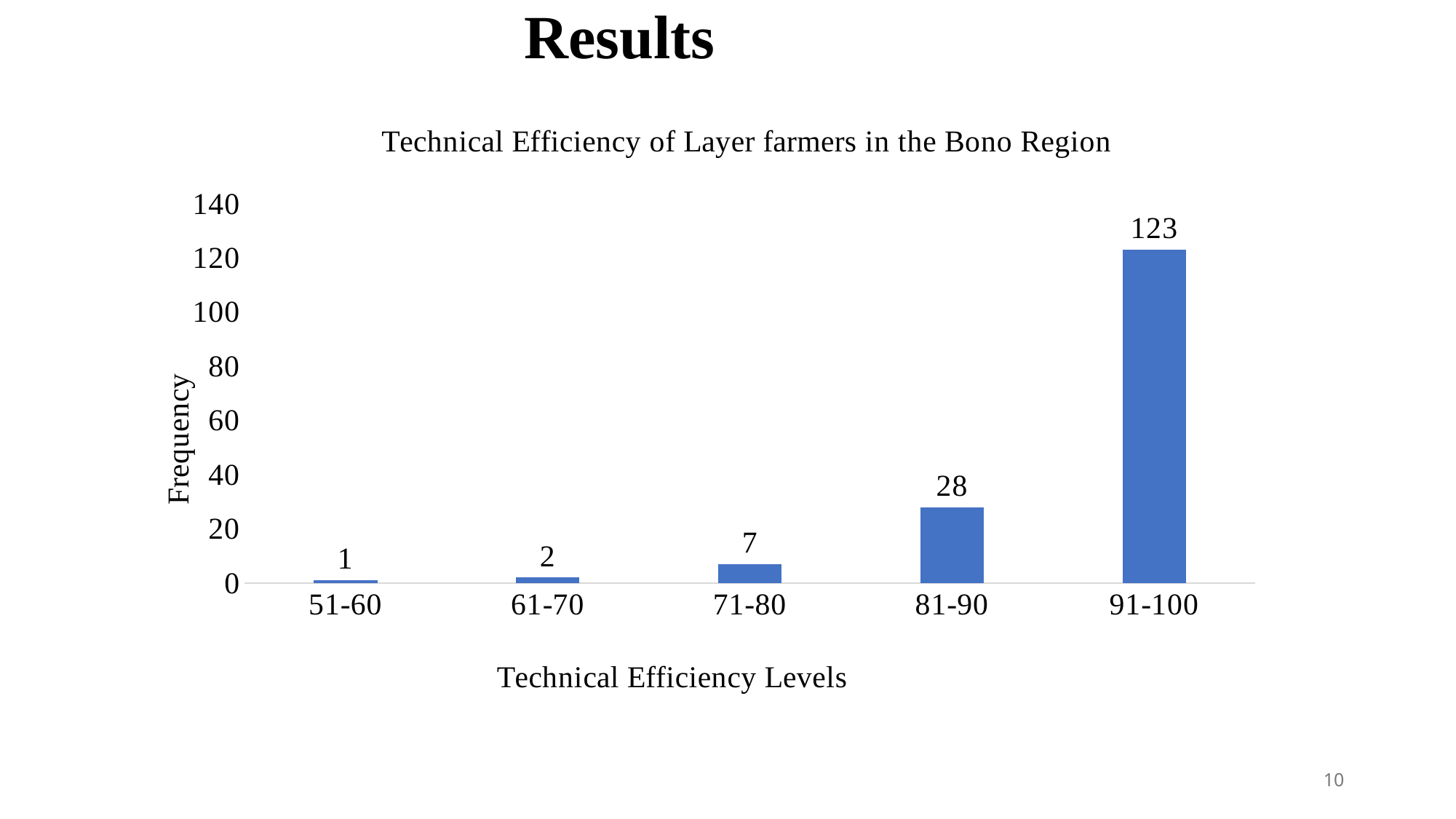
Which technical efficiency level has the highest frequency? 91-100 Which has a higher frequency, the 61-70 level or the 71-80 level? 71-80 What is the title of the chart? Technical Efficiency of Layer farmers in the Bono Region What is the frequency for the 81-90 technical efficiency level? 28 How many technical efficiency levels are shown on the x axis? 5 What is the frequency for the 51-60 technical efficiency level? 1 What is the frequency for the 91-100 technical efficiency level? 123 What kind of chart is shown on the slide? Bar chart Which technical efficiency level has the lowest frequency? 51-60 What is the difference in frequency between the 91-100 and 81-90 levels? 95 Is the frequency for the 91-100 level greater or less than 100? greater What is the frequency for the 71-80 technical efficiency level? 7